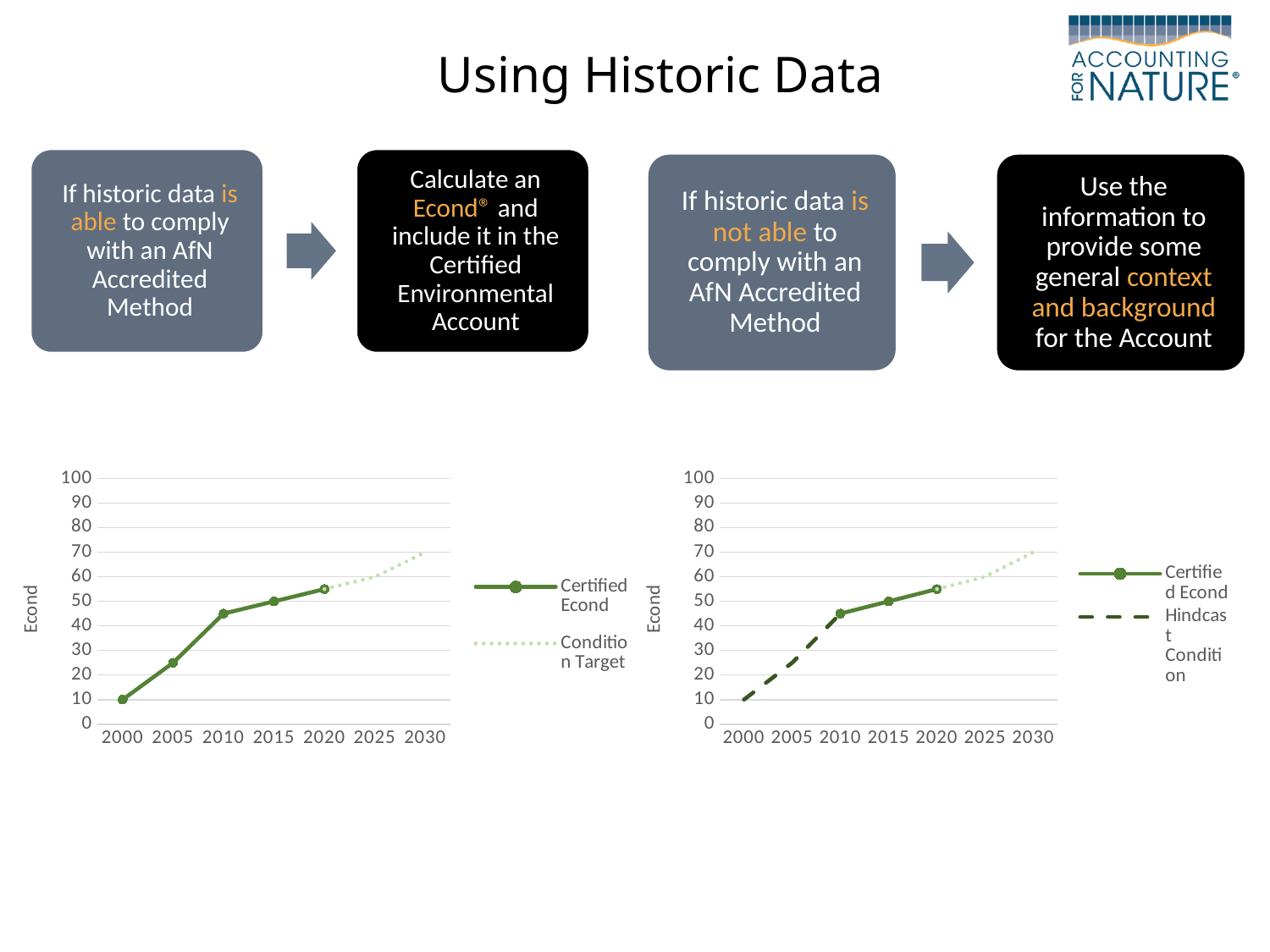
In the left chart, is the Certified Econd value for 2010 greater or less than 40? greater In the right chart, which series is drawn with a dashed line? Hindcast Condition In the right chart, is the Certified Econd value for 2020 greater or less than 50? greater In the left chart, what is the Certified Econd value in 2015? 50 In the left chart, does the Certified Econd line rise or fall from 2000 to 2020? rise What kind of chart is the left chart on the slide? line chart In the left chart, is the Certified Econd value for 2005 greater or less than 30? less How many series does the legend of the left chart list? 2 How many series does the legend of the right chart list? 2 What is the label on the y axis of the right chart? Econd In the right chart, which is larger, the Certified Econd value in 2010 or in 2020? 2020 In the left chart, what is the Certified Econd value in 2000? 10